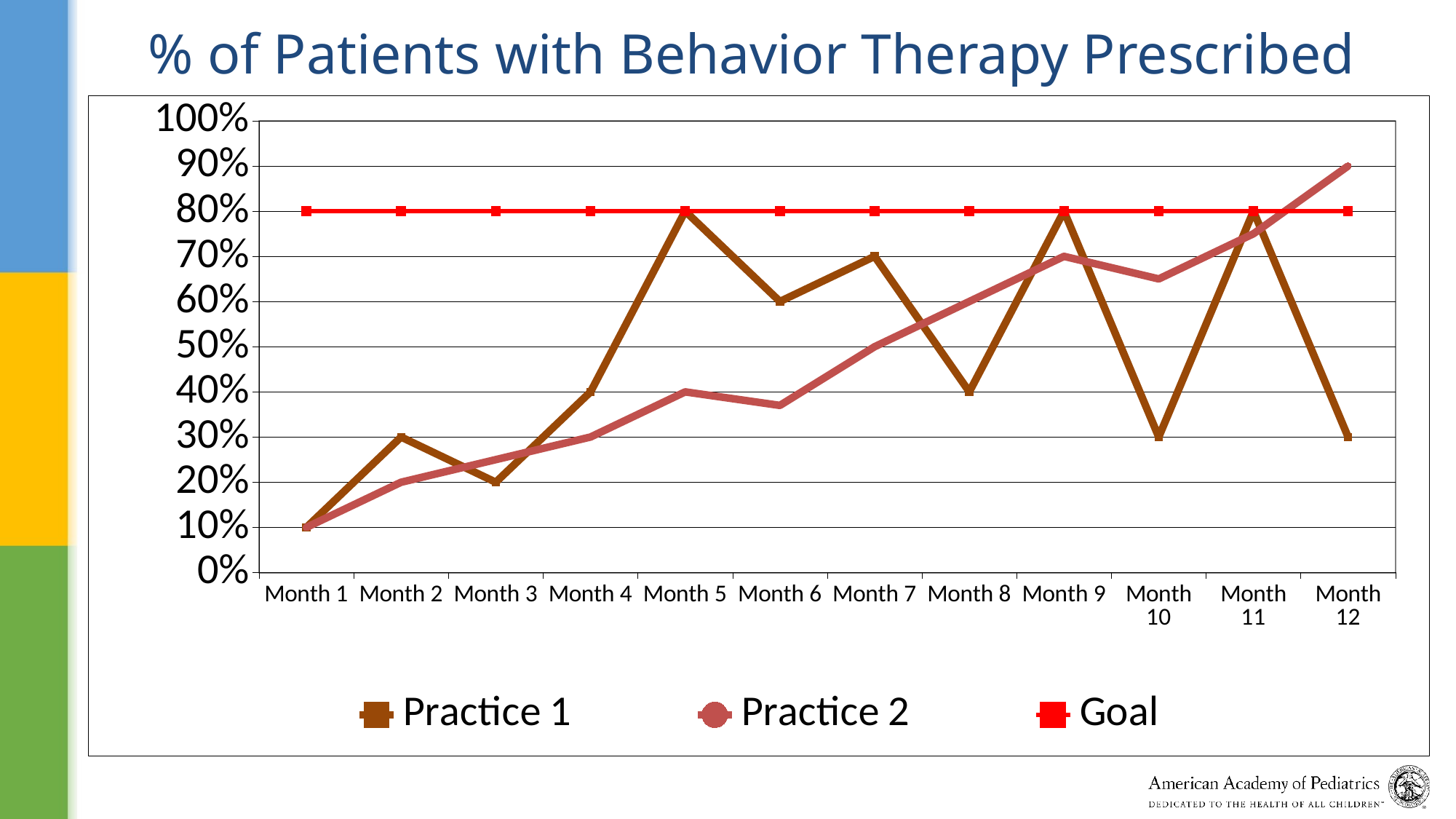
How many series does the legend list? 3 What is the value for Practice 2 in Month 12? 90% What is the value of the Goal line? 80% What is the value for Practice 1 in Month 12? 30% How many months are shown on the x axis? 12 What is the value for Practice 1 in Month 5? 80% In Month 12, which is larger, Practice 1 or Practice 2? Practice 2 In which month does Practice 2 reach its highest value? Month 12 Is the value for Practice 2 in Month 7 greater or less than 40%? greater Is the value for Practice 2 in Month 3 greater or less than 30%? less What kind of chart is shown on the slide? line chart Does the Practice 2 line generally rise or fall from Month 1 to Month 12? rise